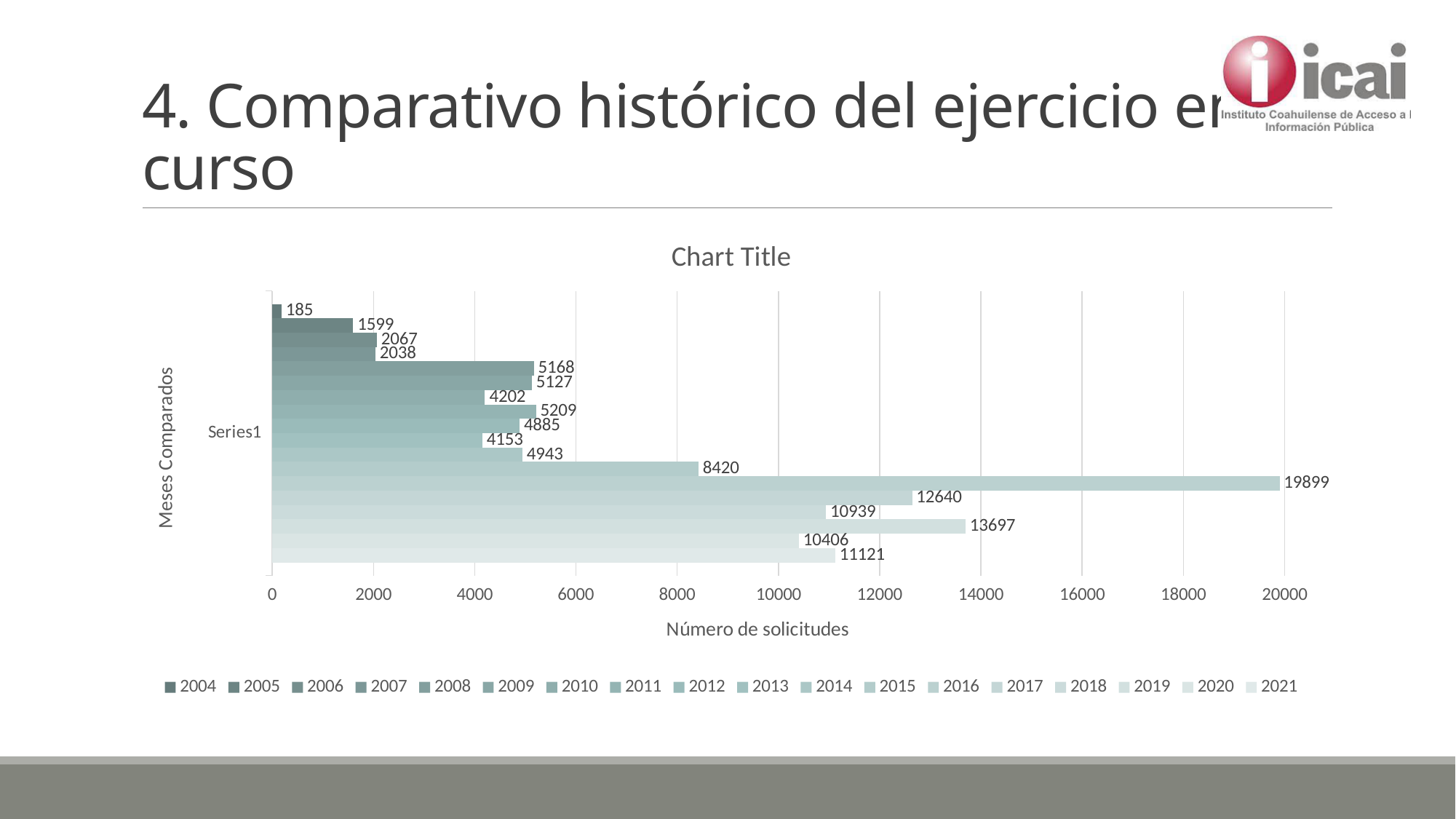
Which year has the highest value? 2016 What is the title of the chart? Chart Title Which year has the lowest value? 2004 What kind of chart is shown on the slide? bar chart Is the value for 2015 greater or less than 8000? greater What is the value for 2016? 19899 What is the value for 2019? 13697 What is the value for 2004? 185 How many series does the legend list? 18 Which is larger, the value for 2018 or the value for 2021? 2021 What is the difference between the values for 2016 and 2017? 7259 What is the label of the x axis? Número de solicitudes